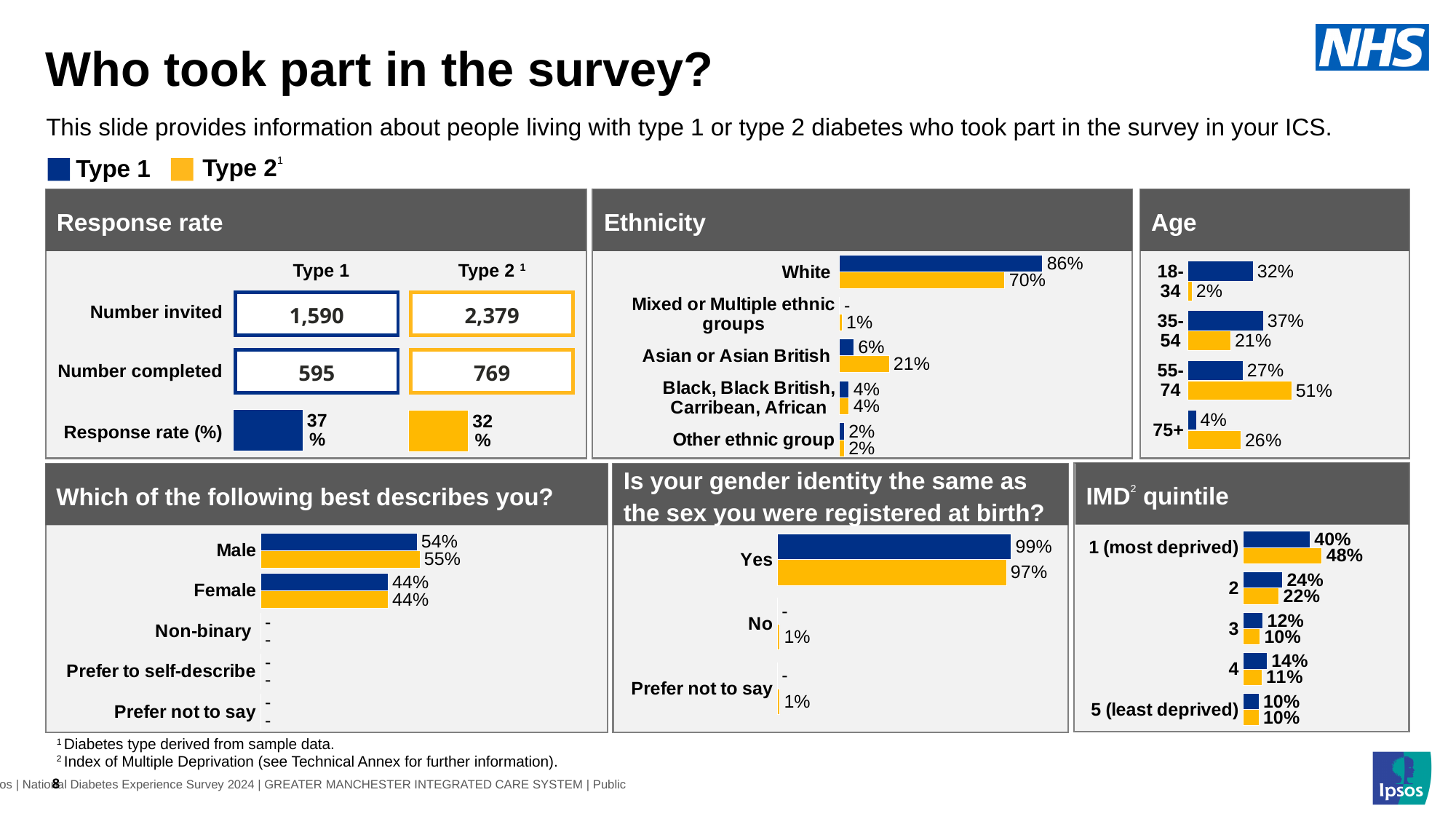
In the Age chart, which age group has the highest Type 1 value? 35-54 In the Response rate panel, which diabetes type has the higher response rate? Type 1 How many ethnic group categories are shown in the Ethnicity chart? 5 In the 'Which of the following best describes you?' chart, what is the Type 2 value for Male? 55% In the IMD quintile chart, what is the difference between the Type 2 and Type 1 values for 1 (most deprived)? 8 percentage points In the Response rate panel, what is the number completed for Type 1? 595 In the Ethnicity chart, what is the Type 1 value for White? 86% In the 'Is your gender identity the same as the sex you were registered at birth?' chart, what is the Type 1 value for Yes? 99% In the Age chart, what is the Type 2 value for the 55-74 age group? 51% In the Age chart, which age group has the lowest Type 1 value? 75+ In the Ethnicity chart, what is the Type 2 value for Asian or Asian British? 21% How many series does the legend at the top of the slide list? 2